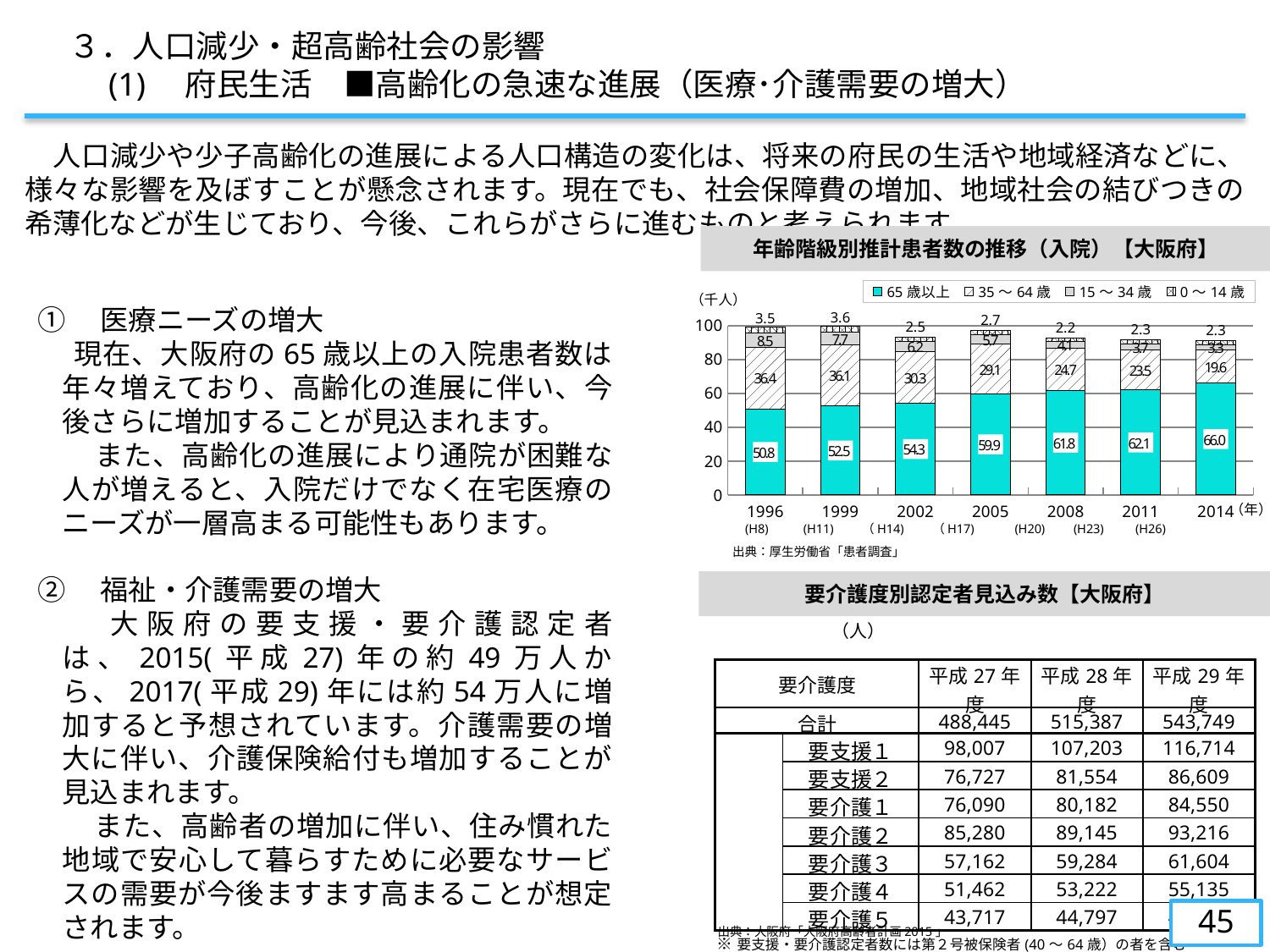
In the chart 年齢階級別推計患者数の推移（入院）【大阪府】, which year has the lowest value for 35～64歳? 2014 In the chart 年齢階級別推計患者数の推移（入院）【大阪府】, what is the value for 65歳以上 in 2014? 66.0 In the chart 年齢階級別推計患者数の推移（入院）【大阪府】, what is the value for 35～64歳 in 1996? 36.4 In the chart 年齢階級別推計患者数の推移（入院）【大阪府】, which year has the highest value for 65歳以上? 2014 In the chart 年齢階級別推計患者数の推移（入院）【大阪府】, what is the difference between the 65歳以上 values for 2014 and 1996? 15.2 In the chart 年齢階級別推計患者数の推移（入院）【大阪府】, does the value for 35～64歳 rise or fall from 1996 to 2014? Fall In the chart 年齢階級別推計患者数の推移（入院）【大阪府】, how many years are shown on the x axis? 7 In the chart 年齢階級別推計患者数の推移（入院）【大阪府】, how many series does the legend list? 4 What kind of chart is 年齢階級別推計患者数の推移（入院）【大阪府】? Stacked bar chart In the chart 年齢階級別推計患者数の推移（入院）【大阪府】, what is the value for 0～14歳 in 1999? 3.6 In the chart 年齢階級別推計患者数の推移（入院）【大阪府】, which is larger in 2008: the value for 65歳以上 or the value for 35～64歳? 65歳以上 In the chart 年齢階級別推計患者数の推移（入院）【大阪府】, what is the value for 15～34歳 in 2005? 5.7